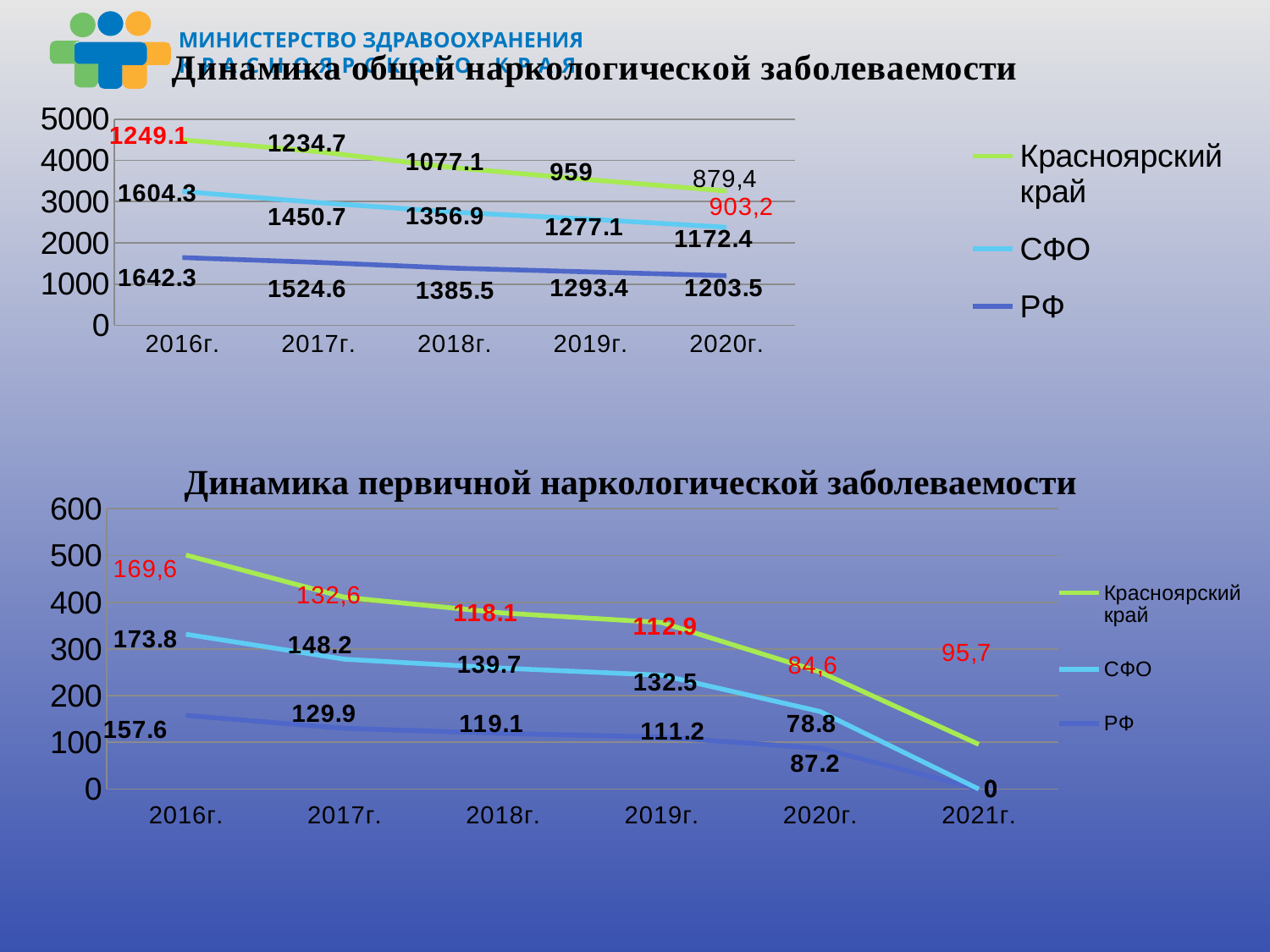
In the bottom chart 'Динамика первичной наркологической заболеваемости', what is the difference between the СФО values for 2016г. and 2017г.? 25.6 How many years are shown on the x axis of the top chart 'Динамика общей наркологической заболеваемости'? 5 How many years are shown on the x axis of the bottom chart 'Динамика первичной наркологической заболеваемости'? 6 How many series does the legend of the top chart 'Динамика общей наркологической заболеваемости' list? 3 In the bottom chart 'Динамика первичной наркологической заболеваемости', what is the value for Красноярский край in 2018г.? 118.1 In the top chart 'Динамика общей наркологической заболеваемости', what is the value for СФО in 2018г.? 1356.9 In the top chart 'Динамика общей наркологической заболеваемости', what is the value for РФ in 2016г.? 1642.3 What kind of chart is the top chart, 'Динамика общей наркологической заболеваемости'? line chart In the bottom chart 'Динамика первичной наркологической заболеваемости', which year has the larger РФ value, 2017г. or 2018г.? 2017г. In the top chart 'Динамика общей наркологической заболеваемости', what is the difference between the РФ values for 2016г. and 2020г.? 438.8 In the bottom chart 'Динамика первичной наркологической заболеваемости', what is the value for СФО in 2019г.? 132.5 In the top chart 'Динамика общей наркологической заболеваемости', does the Красноярский край line rise or fall from 2016г. to 2020г.? fall